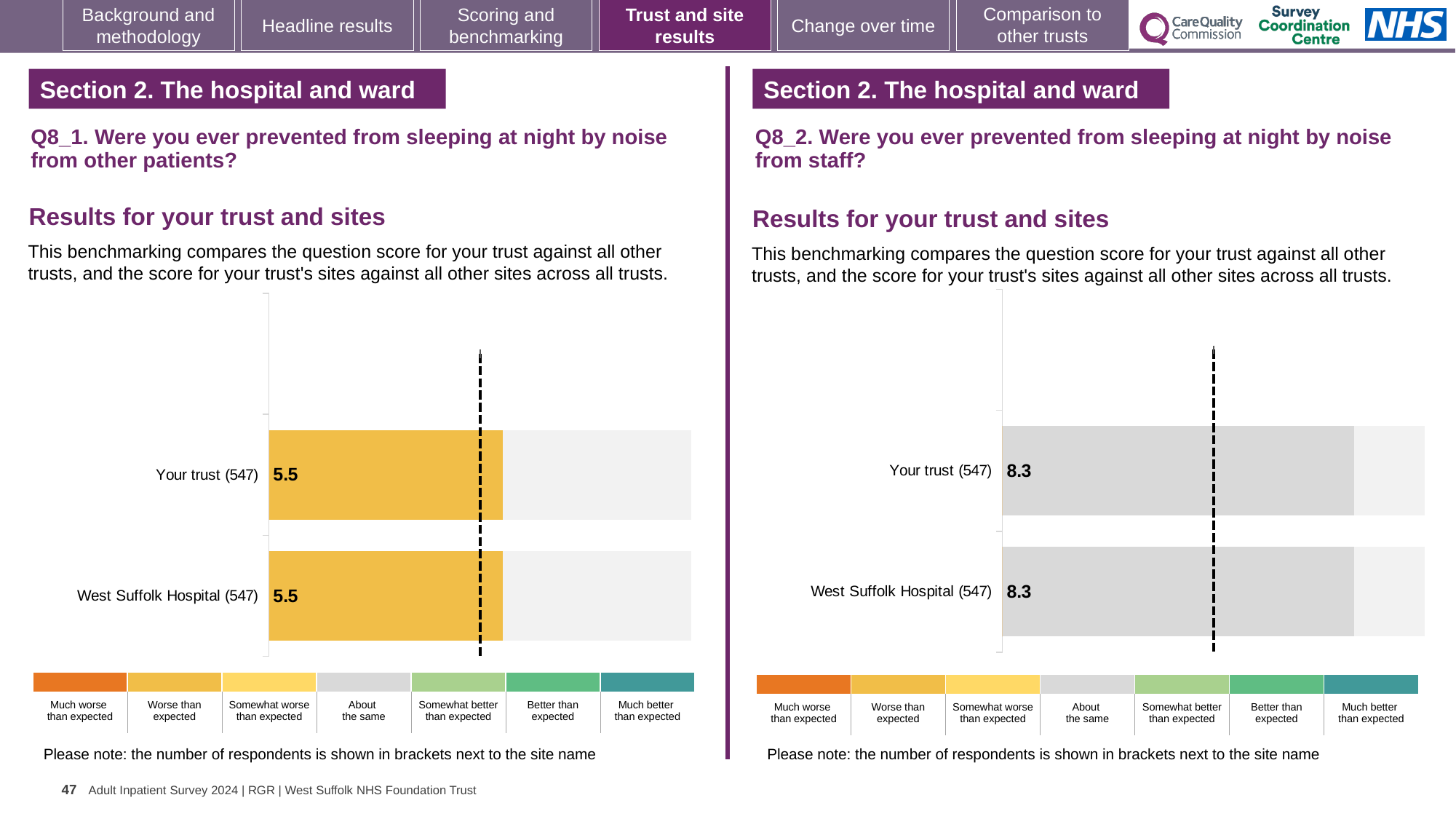
What kind of chart is used for the Q8_2 results (right)? Bar chart On the Q8_2 chart (right), what is the difference between the score for Your trust and the score for West Suffolk Hospital? 0 On the Q8_1 chart (left), what is the score for Your trust (547)? 5.5 On the Q8_1 chart (left), what is the difference between the score for Your trust and the score for West Suffolk Hospital? 0 On the Q8_2 chart (right), what is the score for Your trust (547)? 8.3 On the Q8_1 chart (left), what is the score for West Suffolk Hospital (547)? 5.5 On the Q8_1 chart (left), which benchmark category does the colour of the bars correspond to according to the legend? Worse than expected On the Q8_2 chart (right), which benchmark category does the colour of the bars correspond to according to the legend? About the same How many bars are plotted on the Q8_1 chart (left)? 2 How many bars are plotted on the Q8_2 chart (right)? 2 On the Q8_2 chart (right), what is the score for West Suffolk Hospital (547)? 8.3 How many respondents are shown in brackets for West Suffolk Hospital on the Q8_2 chart (right)? 547